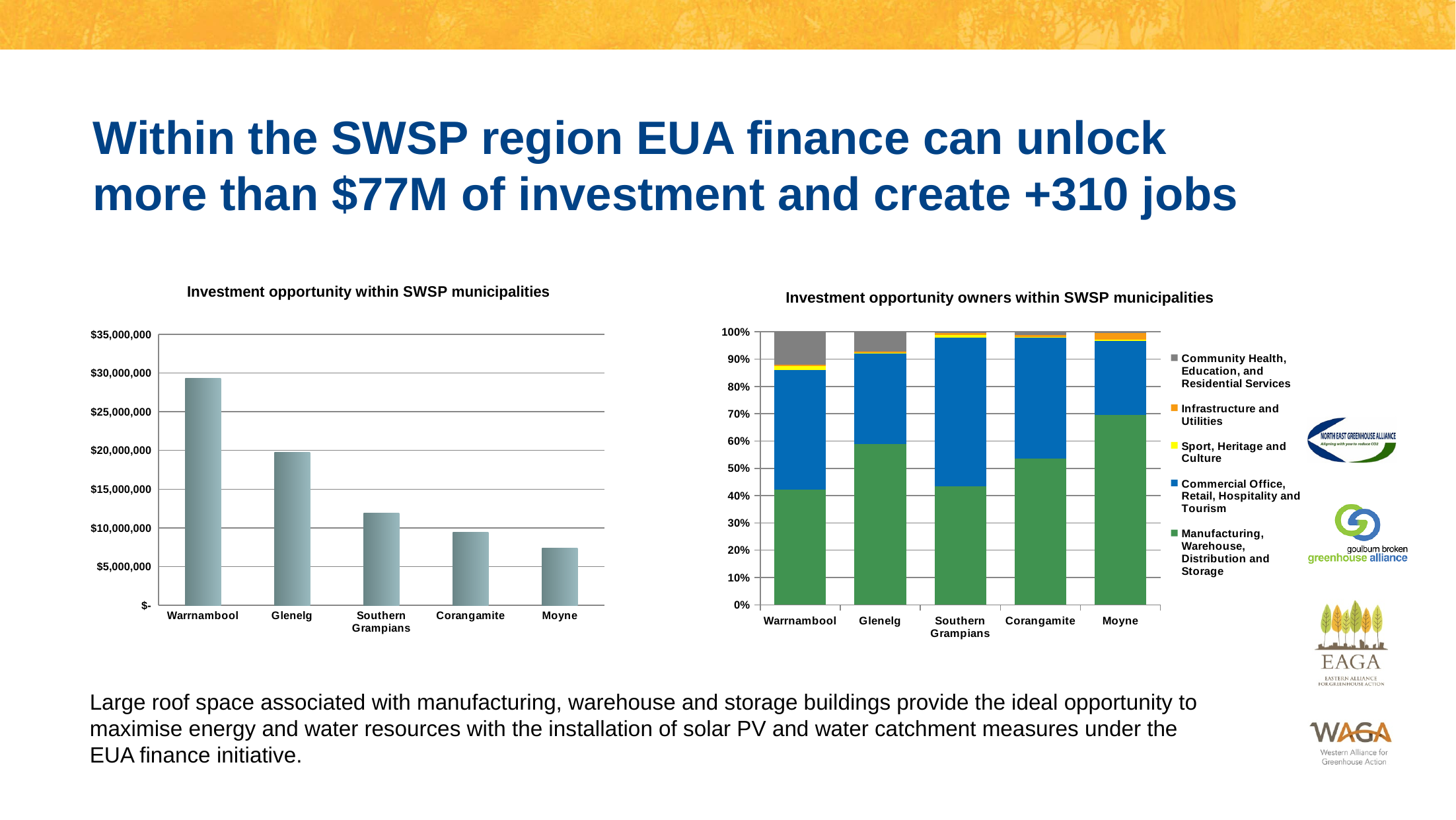
In the chart titled "Investment opportunity within SWSP municipalities", which municipality has the lowest investment opportunity? Moyne In the chart titled "Investment opportunity owners within SWSP municipalities", is the Manufacturing, Warehouse, Distribution and Storage share for Warrnambool greater or less than 50%? less In the chart titled "Investment opportunity within SWSP municipalities", which is larger, the value for Southern Grampians or the value for Corangamite? Southern Grampians In the chart titled "Investment opportunity within SWSP municipalities", do the values rise or fall from left to right along the x axis? fall In the chart titled "Investment opportunity owners within SWSP municipalities", which municipality has the largest share for Manufacturing, Warehouse, Distribution and Storage? Moyne In the chart titled "Investment opportunity within SWSP municipalities", how many municipalities are plotted? 5 In the chart titled "Investment opportunity owners within SWSP municipalities", how many series does the legend list? 5 In the chart titled "Investment opportunity within SWSP municipalities", what kind of chart is shown? bar chart In the chart titled "Investment opportunity within SWSP municipalities", is the value for Moyne greater or less than $10,000,000? less In the chart titled "Investment opportunity within SWSP municipalities", which municipality has the highest investment opportunity? Warrnambool In the chart titled "Investment opportunity within SWSP municipalities", is the value for Warrnambool greater or less than $25,000,000? greater